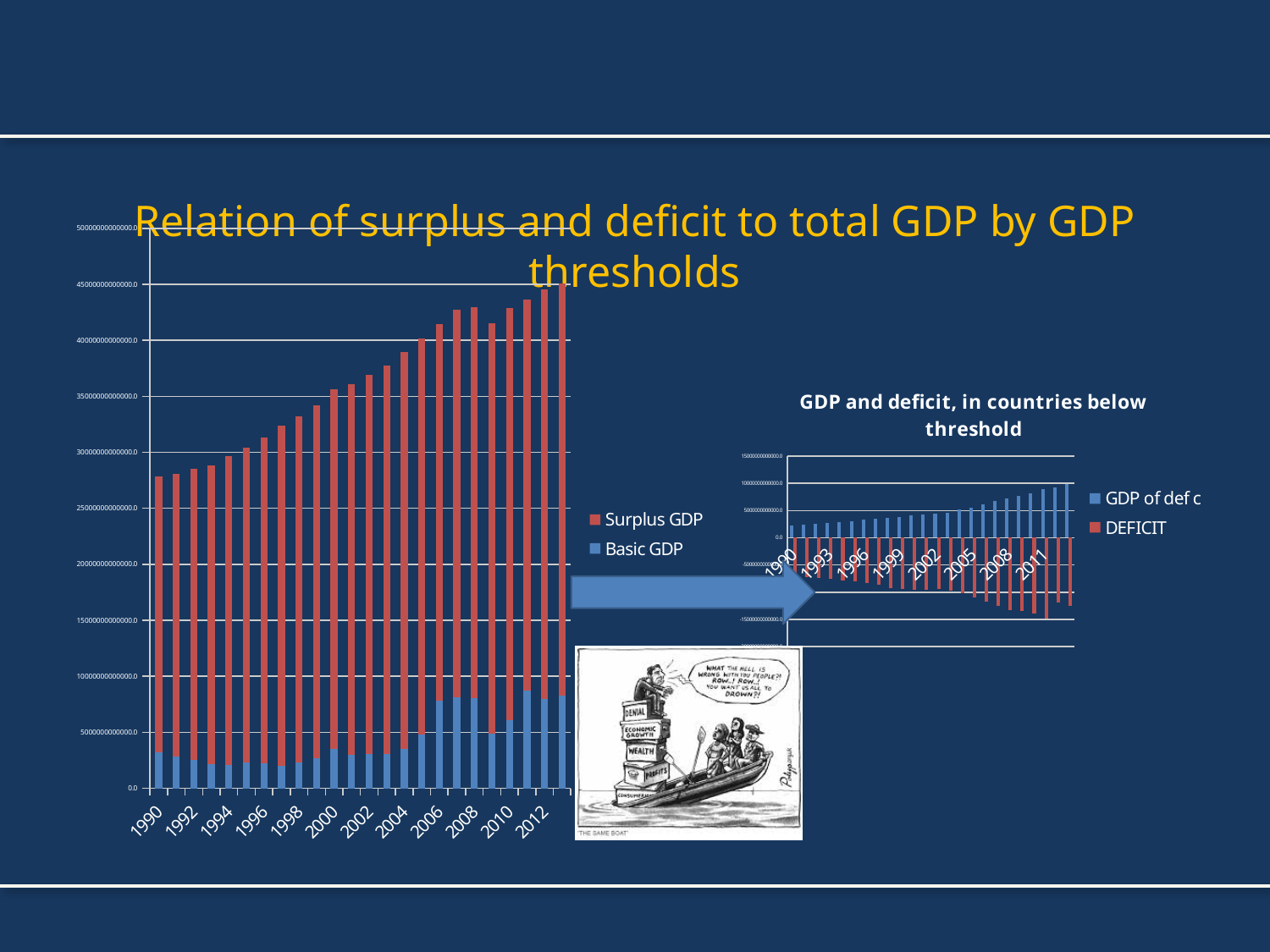
In the left chart 'Relation of surplus and deficit to total GDP by GDP thresholds', is the Basic GDP value for 2008 greater or less than 5000000000000.0? greater In the left chart 'Relation of surplus and deficit to total GDP by GDP thresholds', do the total stacked bar heights generally rise or fall from 1990 to 2012? Rise In the left chart 'Relation of surplus and deficit to total GDP by GDP thresholds', is the Basic GDP value for 1990 greater or less than 5000000000000.0? less In the left chart 'Relation of surplus and deficit to total GDP by GDP thresholds', which series is shown in blue? Basic GDP In the left chart 'Relation of surplus and deficit to total GDP by GDP thresholds', is the total stacked bar for 1990 greater or less than 25000000000000.0? greater How many series does the legend of the right chart 'GDP and deficit, in countries below threshold' list? 2 How many series does the legend of the left chart 'Relation of surplus and deficit to total GDP by GDP thresholds' list? 2 What kind of chart is the large chart on the left titled 'Relation of surplus and deficit to total GDP by GDP thresholds'? Bar chart What is the title of the smaller chart on the right of the slide? GDP and deficit, in countries below threshold In the right chart 'GDP and deficit, in countries below threshold', do the GDP of def c bars rise or fall from 1990 to 2011? Rise In the left chart 'Relation of surplus and deficit to total GDP by GDP thresholds', is the Basic GDP value larger in 1990 or in 2008? 2008 In the left chart 'Relation of surplus and deficit to total GDP by GDP thresholds', which series has the larger value in 2000, Surplus GDP or Basic GDP? Surplus GDP